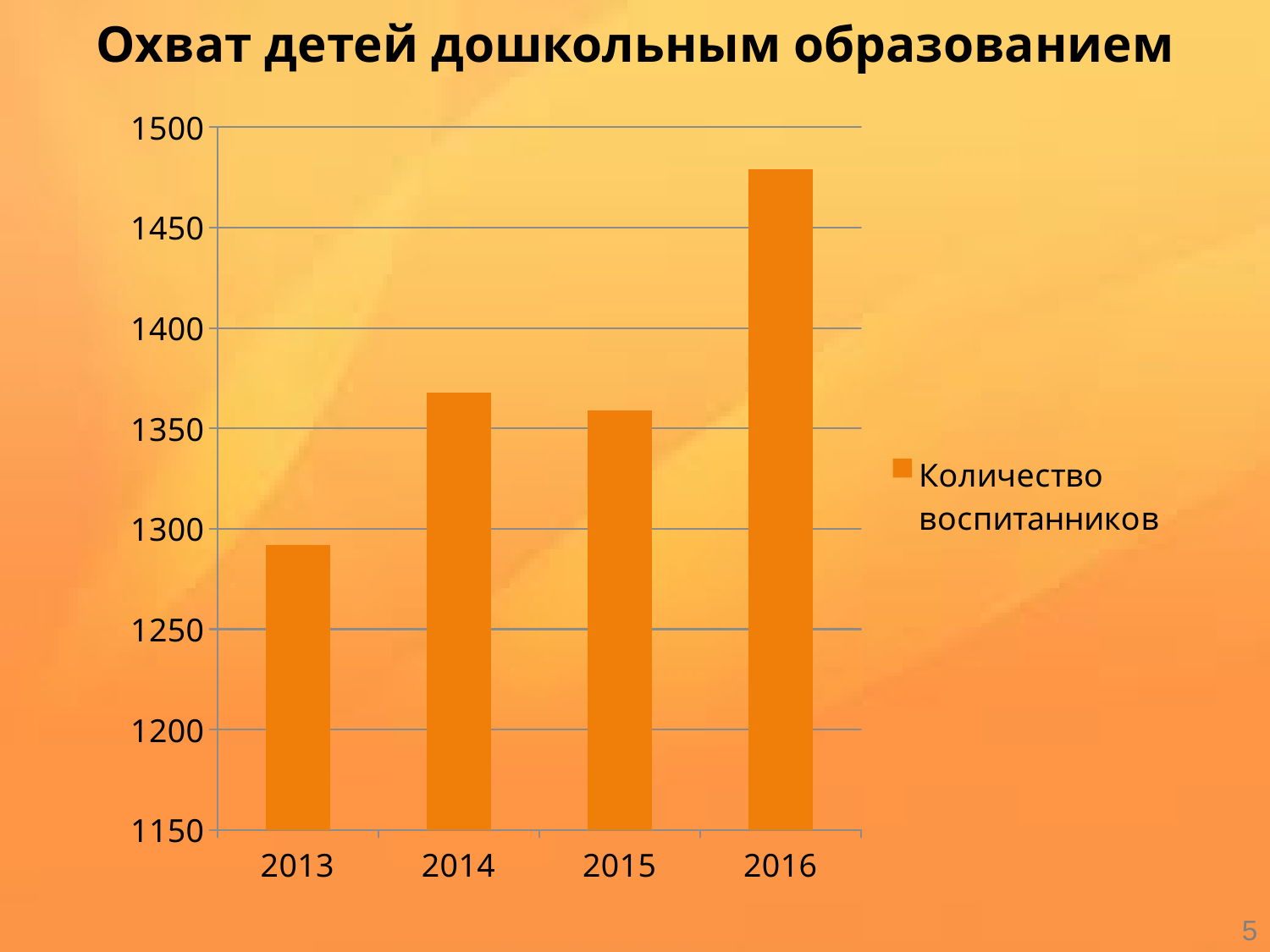
Is the value for 2016 greater or less than 1450? greater What kind of chart is shown on the slide? bar chart What series name is shown in the chart legend? Количество воспитанников Is the value for 2013 greater or less than 1300? less What is the title of the chart on the slide? Охват детей дошкольным образованием Which year has the highest number of pupils (Количество воспитанников)? 2016 Which is larger, the value for 2016 or the value for 2013? 2016 How many years are shown on the x axis of the chart? 4 Is the value for 2014 greater or less than 1350? greater Which year has the lowest number of pupils (Количество воспитанников)? 2013 How many series does the chart legend list? 1